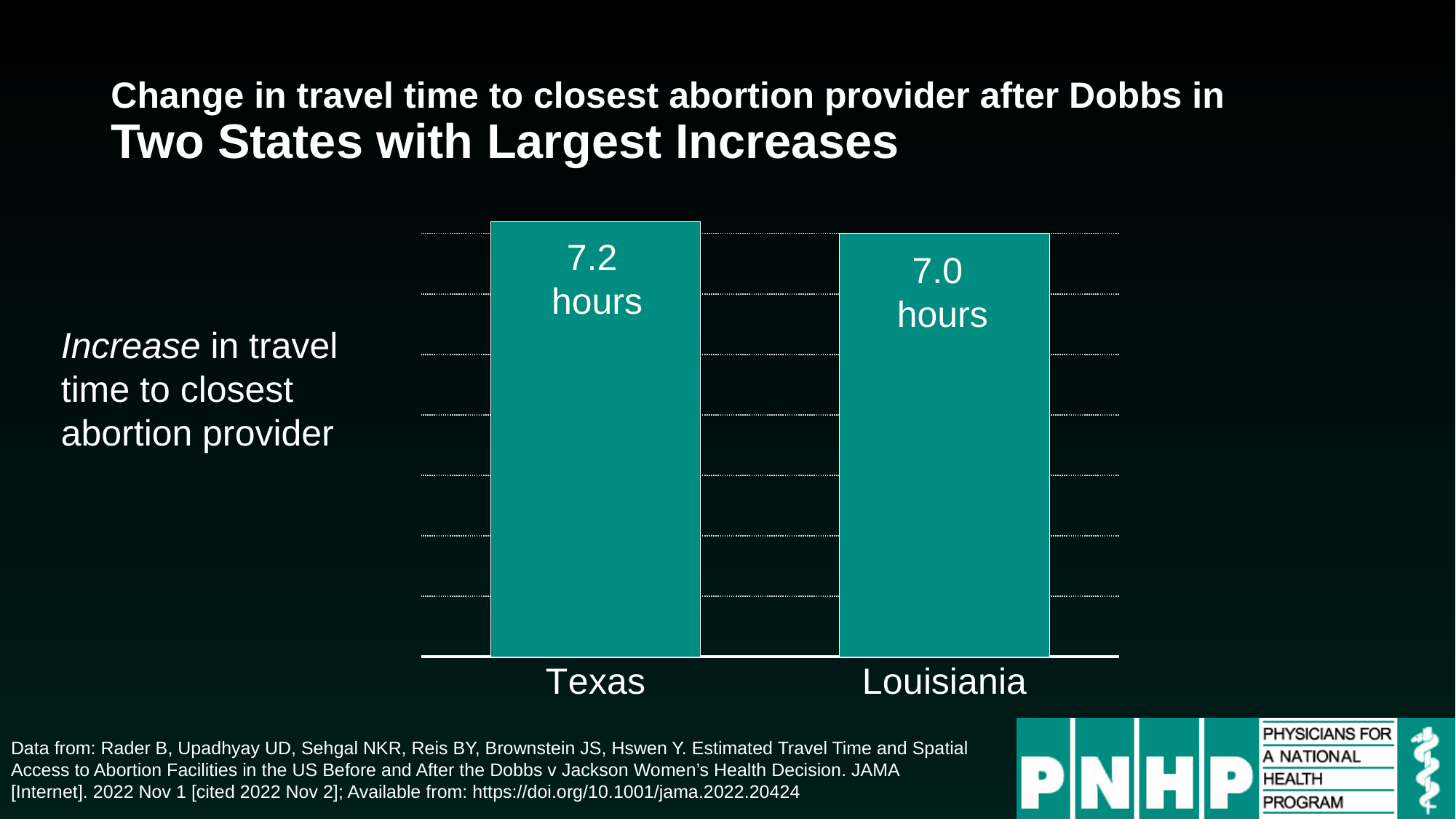
Which state has the smaller increase in travel time? Louisiana How many states are shown in the chart? 2 Which state has the larger increase in travel time? Texas What is the increase in travel time to the closest abortion provider for Louisiana? 7.0 hours What is the title of the slide's chart? Change in travel time to closest abortion provider after Dobbs in Two States with Largest Increases What is the increase in travel time to the closest abortion provider for Texas? 7.2 hours What is the difference between the Texas and Louisiana increases in travel time? 0.2 hours What kind of chart is shown on the slide? Bar chart Is the increase in travel time larger for Texas or for Louisiana? Texas What colour are the bars in the chart? Teal Do the values fall or rise going from Texas to Louisiana? Fall